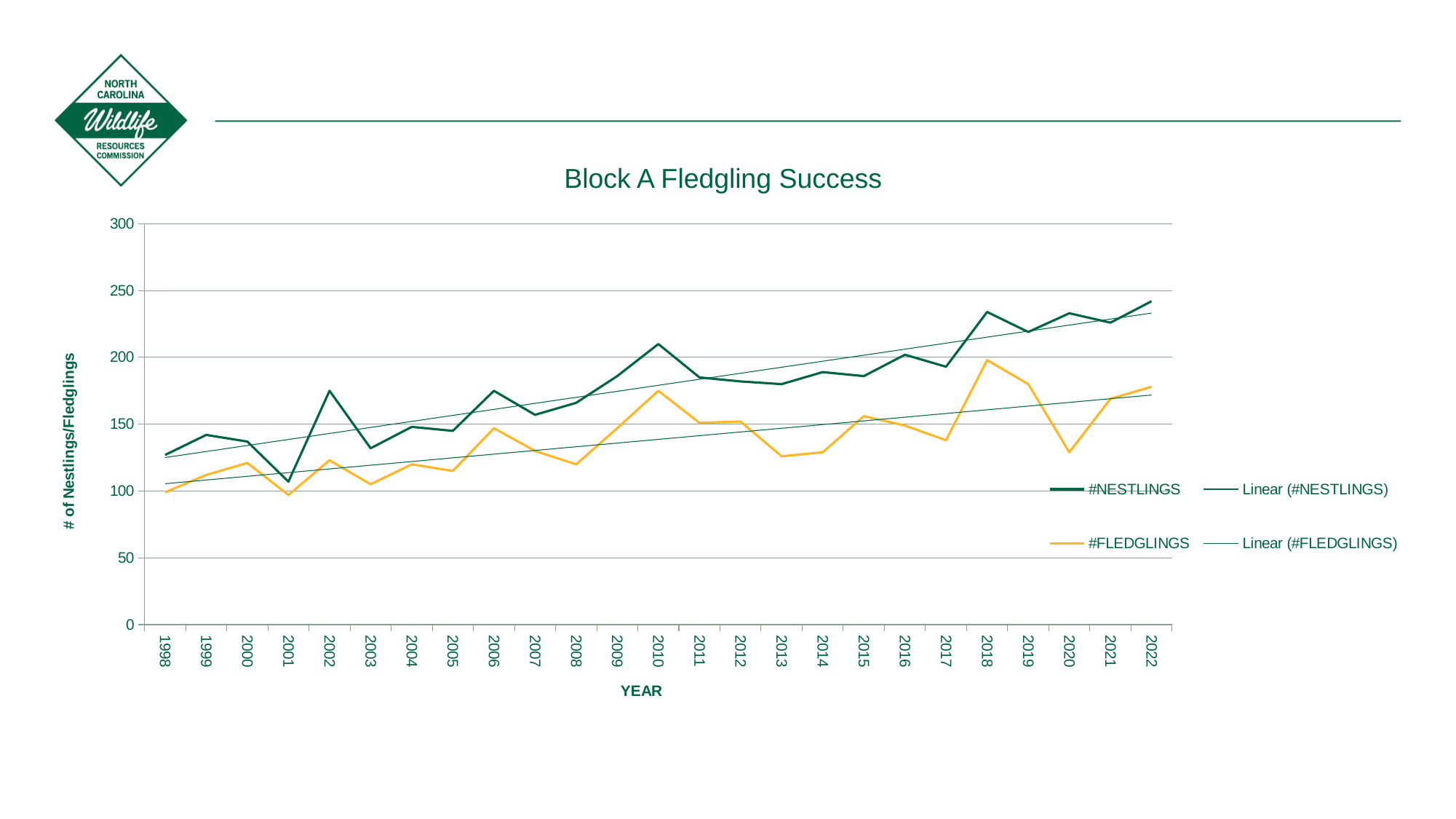
Is the #FLEDGLINGS value for 2020 greater or less than 150? less What is the title of the chart? Block A Fledgling Success Which year has the larger #FLEDGLINGS value, 2018 or 2019? 2018 How many years are plotted along the x axis? 25 Does the #NESTLINGS series generally rise or fall from 1998 to 2022? Rise What type of chart is shown on the slide? Line chart Is the #NESTLINGS value for 2010 greater or less than 200? greater In which year is the #NESTLINGS value lowest? 2001 In which year is the #NESTLINGS value highest? 2022 Is the #NESTLINGS value for 2002 greater or less than 150? greater How many entries does the chart legend list? 4 In which year is the #FLEDGLINGS value highest? 2018